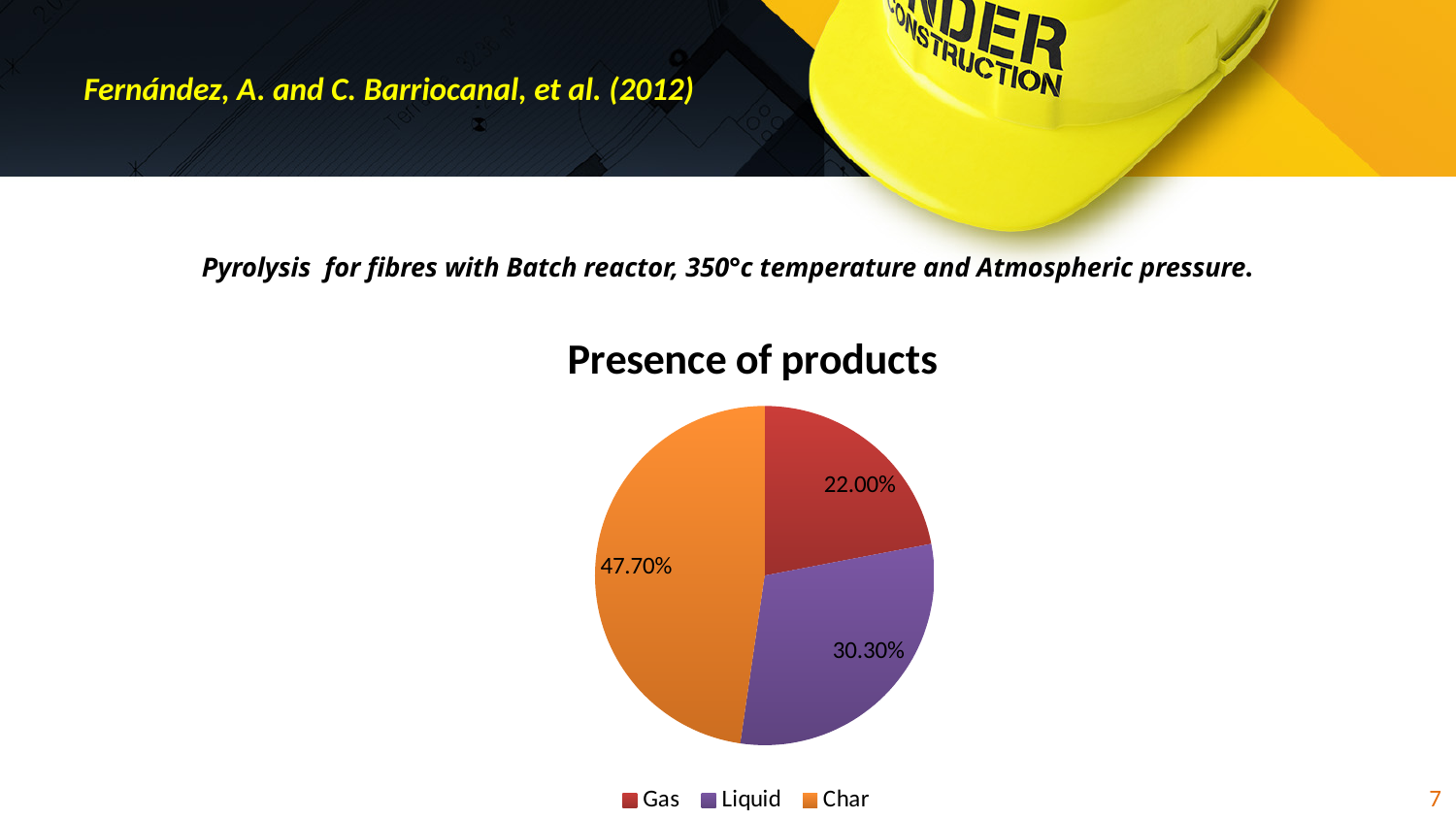
What is the difference in percentage points between the Liquid and Gas slices? 8.30% What percentage of the pie does Char account for? 47.70% What percentage of the pie does Gas account for? 22.00% How many slices does the pie chart have? 3 Which product has the smallest share of the pie? Gas What type of chart is shown on the slide? pie chart What percentage of the pie does Liquid account for? 30.30% What is the difference in percentage points between the Char and Gas slices? 25.70% Which product is shown in orange in the legend? Char Which product has the largest share of the pie? Char What is the title of the chart? Presence of products Which is larger, the Liquid slice or the Gas slice? Liquid